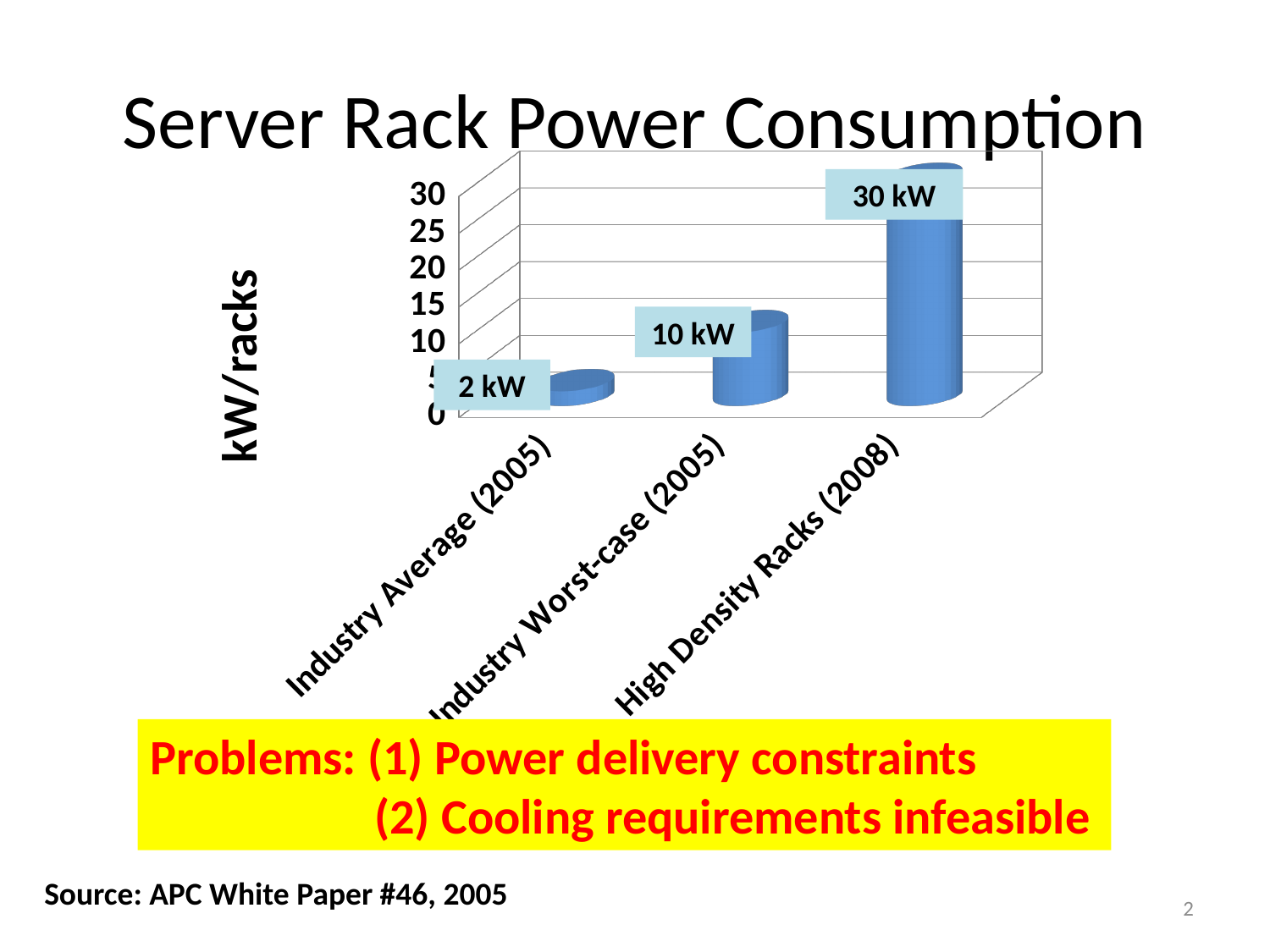
Which category has the highest power consumption? High Density Racks (2008) What is the label of the vertical axis? kW/racks What is the value for Industry Worst-case (2005)? 10 kW What kind of chart is shown on the slide? bar chart Which is larger, Industry Worst-case (2005) or Industry Average (2005)? Industry Worst-case (2005) Which category has the lowest power consumption? Industry Average (2005) How many categories are shown in the chart? 3 What is the value for High Density Racks (2008)? 30 kW What is the value for Industry Average (2005)? 2 kW What is the difference between High Density Racks (2008) and Industry Worst-case (2005)? 20 kW What is the difference between Industry Worst-case (2005) and Industry Average (2005)? 8 kW Is the value for High Density Racks (2008) greater or less than 25? greater